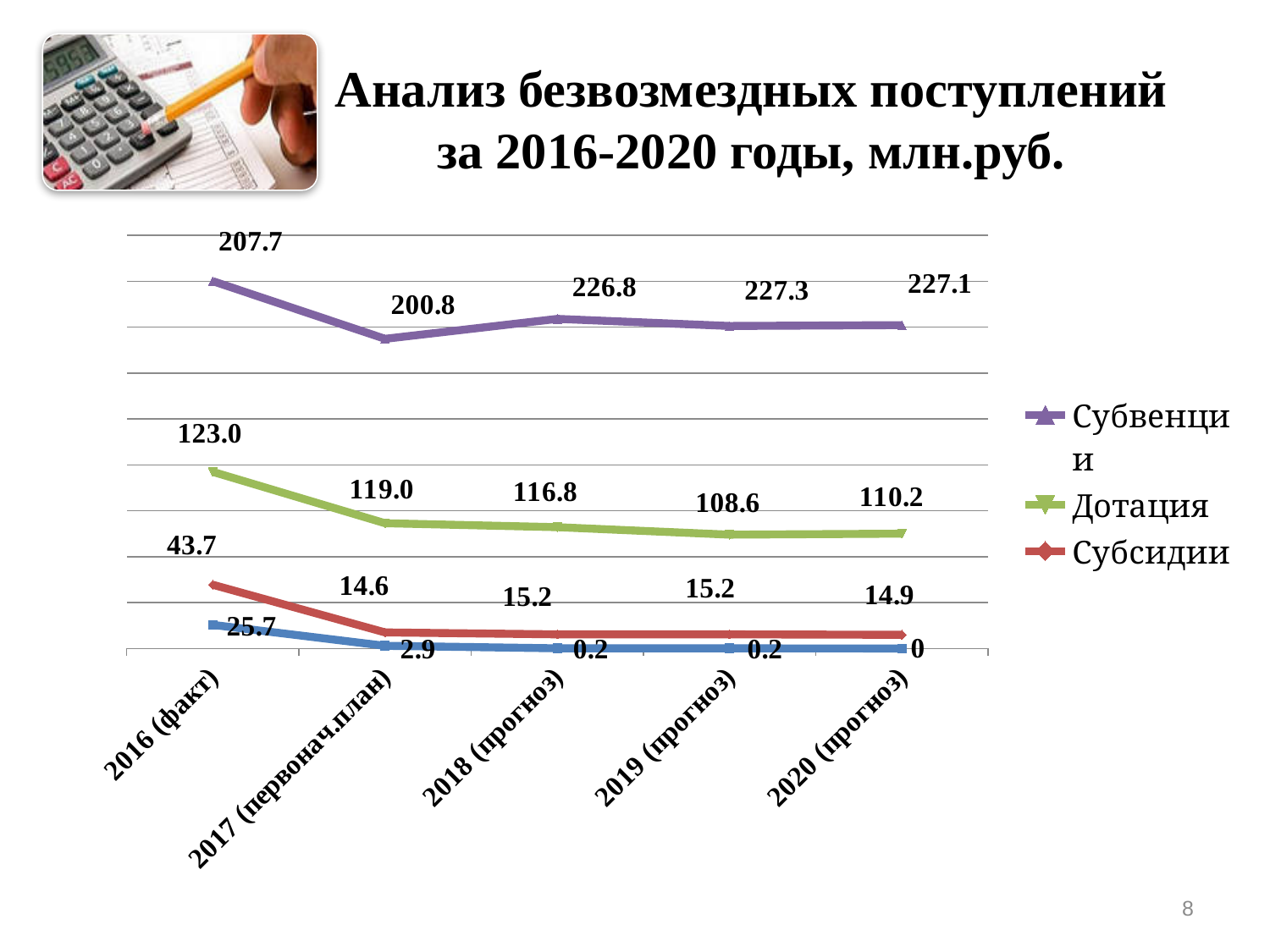
What is the difference between Субвенции in 2016 (факт) and 2017 (первонач.план)? 6.9 In which year does Субвенции reach its highest value? 2019 (прогноз) What is the value for Субсидии in 2016 (факт)? 43.7 Which is larger for Субсидии: the value in 2016 (факт) or in 2017 (первонач.план)? 2016 (факт) What kind of chart is shown on the slide? Line chart What is the value for Субвенции in 2018 (прогноз)? 226.8 In which year is Дотация at its lowest value? 2019 (прогноз) How many series does the legend list? 3 How many years (categories) are shown on the x axis? 5 Does Дотация rise or fall from 2016 (факт) to 2019 (прогноз)? Fall By how much does Дотация decrease from 2016 (факт) to 2017 (первонач.план)? 4.0 What is the value for Дотация in 2019 (прогноз)? 108.6